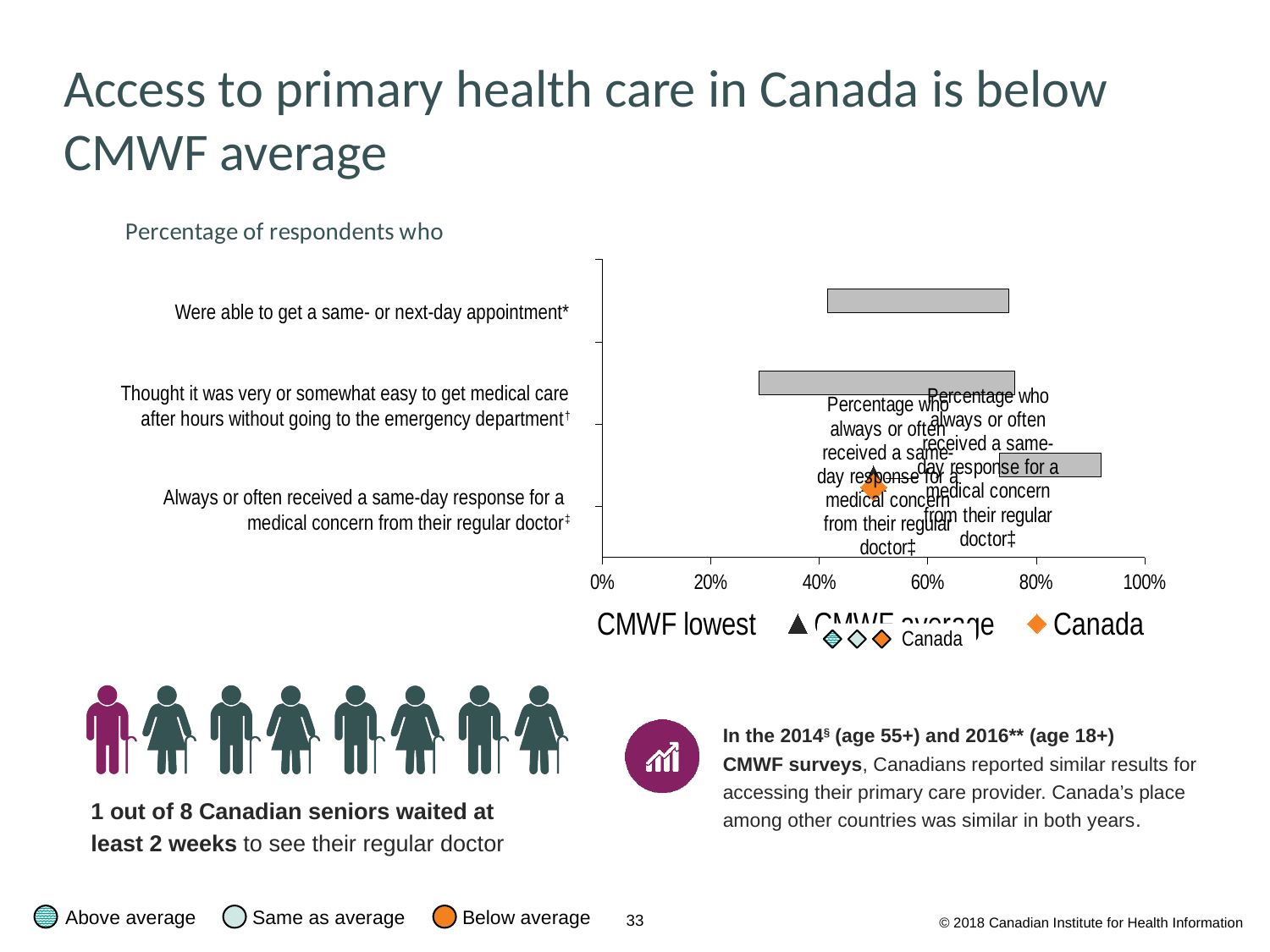
What are the three entries in the chart legend? CMWF lowest, CMWF average, Canada Which category's bar extends furthest to the right on the chart? Always or often received a same-day response for a medical concern from their regular doctor Is the right end of the bar for 'Were able to get a same- or next-day appointment' greater or less than 80%? less How many series does the chart legend list? 3 Which category's bar starts furthest to the left on the chart? Thought it was very or somewhat easy to get medical care after hours without going to the emergency department Is the left end of the bar for 'Always or often received a same-day response for a medical concern from their regular doctor' greater or less than 40%? greater Is the right end of the bar for 'Always or often received a same-day response for a medical concern from their regular doctor' greater or less than 80%? greater How many categories (survey measures) are plotted on the chart? 3 What is the highest value shown on the chart's horizontal axis? 100% What kind of chart is shown on the slide? Bar chart Does the bar for 'Were able to get a same- or next-day appointment' or the bar for 'Always or often received a same-day response for a medical concern from their regular doctor' reach a higher percentage? Always or often received a same-day response for a medical concern from their regular doctor